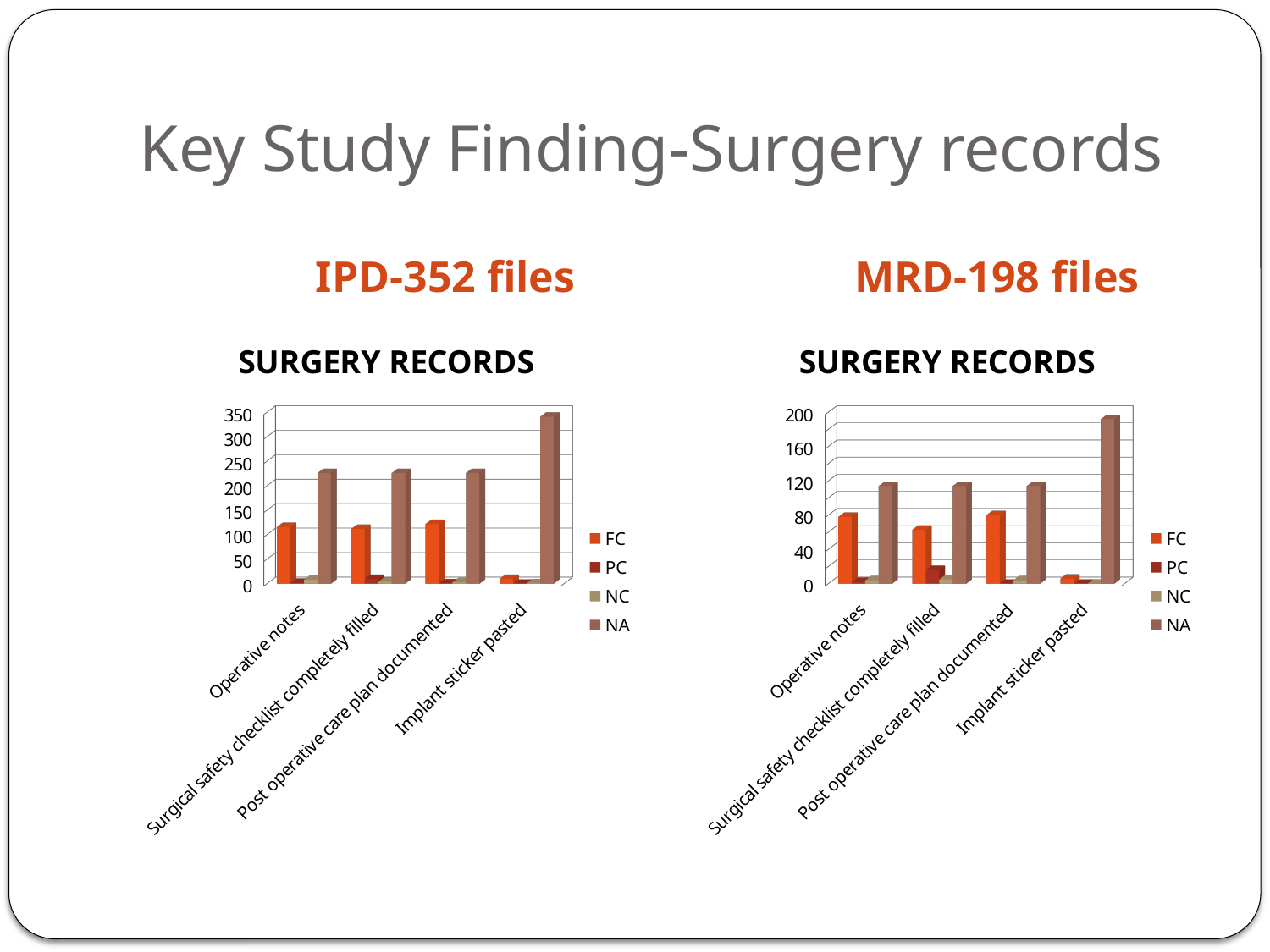
On the left chart (IPD-352 files), which category has the highest NA value? Implant sticker pasted On the left chart (IPD-352 files), how many series does the legend list? 4 On the left chart (IPD-352 files), how many categories are shown on the x axis? 4 On the left chart (IPD-352 files), is the FC value for Operative notes greater or less than 100? greater On the left chart (IPD-352 files), what kind of chart is shown? Bar chart On the right chart (MRD-198 files), which category has the lowest FC value? Implant sticker pasted On the right chart (MRD-198 files), is the FC value for Surgical safety checklist completely filled greater or less than 80? less On the left chart (IPD-352 files), is the NA value for Implant sticker pasted greater or less than 300? greater On the left chart (IPD-352 files), for Operative notes, which is larger: FC or NA? NA On the right chart (MRD-198 files), what are the legend entries? FC, PC, NC, NA